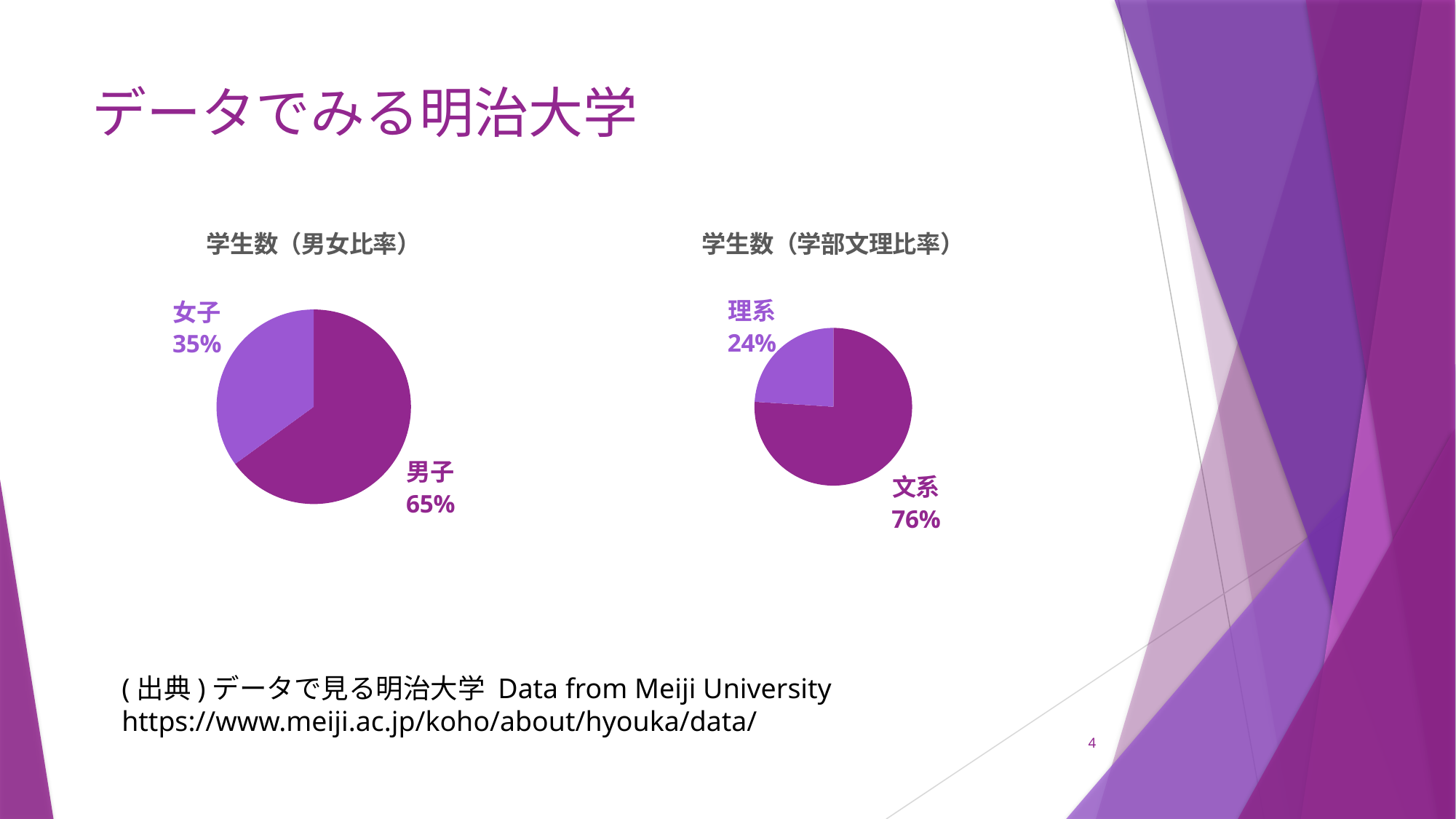
In the chart titled 学生数（学部文理比率）, which category has the smallest share? 理系 In the chart titled 学生数（男女比率）, which category has the largest share? 男子 In the chart titled 学生数（学部文理比率）, what is the value for 文系? 76% In the chart titled 学生数（男女比率）, what is the difference between the 男子 and 女子 shares? 30% How many charts are shown on the slide? 2 In the chart titled 学生数（男女比率）, what is the value for 男子? 65% In the chart titled 学生数（男女比率）, what is the value for 女子? 35% How many slices does the chart titled 学生数（学部文理比率） have? 2 What kind of chart is the chart titled 学生数（男女比率）? Pie chart In the chart titled 学生数（学部文理比率）, what is the difference between the 文系 and 理系 shares? 52% In the chart titled 学生数（学部文理比率）, which is larger, 文系 or 理系? 文系 In the chart titled 学生数（学部文理比率）, what is the value for 理系? 24%